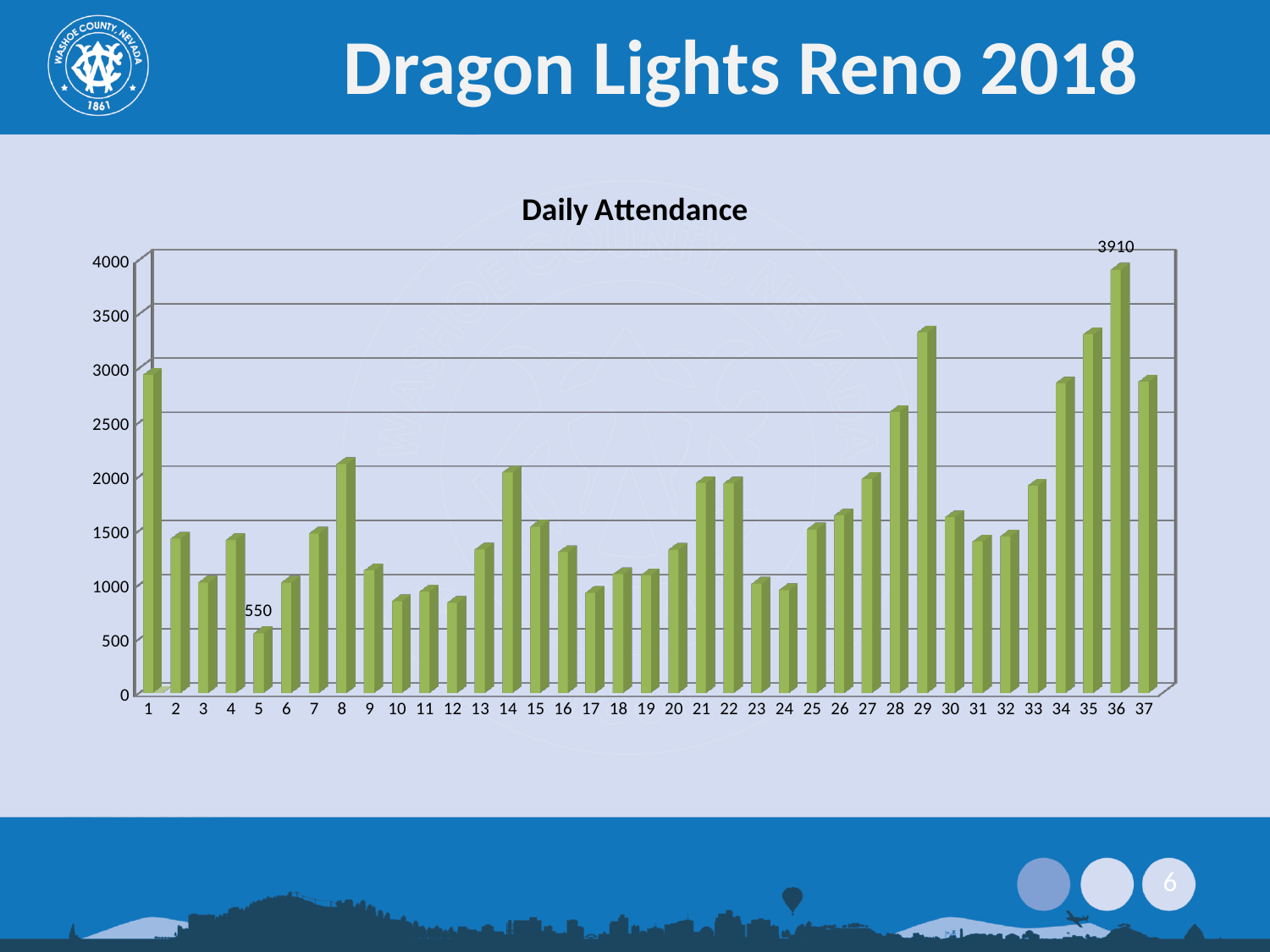
Which day has the highest daily attendance? 36 How many days are shown on the x axis of the chart? 37 What is the attendance value labelled on day 5? 550 Is the attendance on day 1 greater or less than 2500? greater What is the attendance value labelled on day 36? 3910 Which day has the lowest daily attendance? 5 What is the difference between the attendance on day 36 and day 5? 3360 What is the title of the chart? Daily Attendance What kind of chart is used to show daily attendance? bar chart Is the attendance on day 10 greater or less than 1000? less Is the attendance on day 21 greater or less than 1500? greater Which day has higher attendance, day 13 or day 14? 14